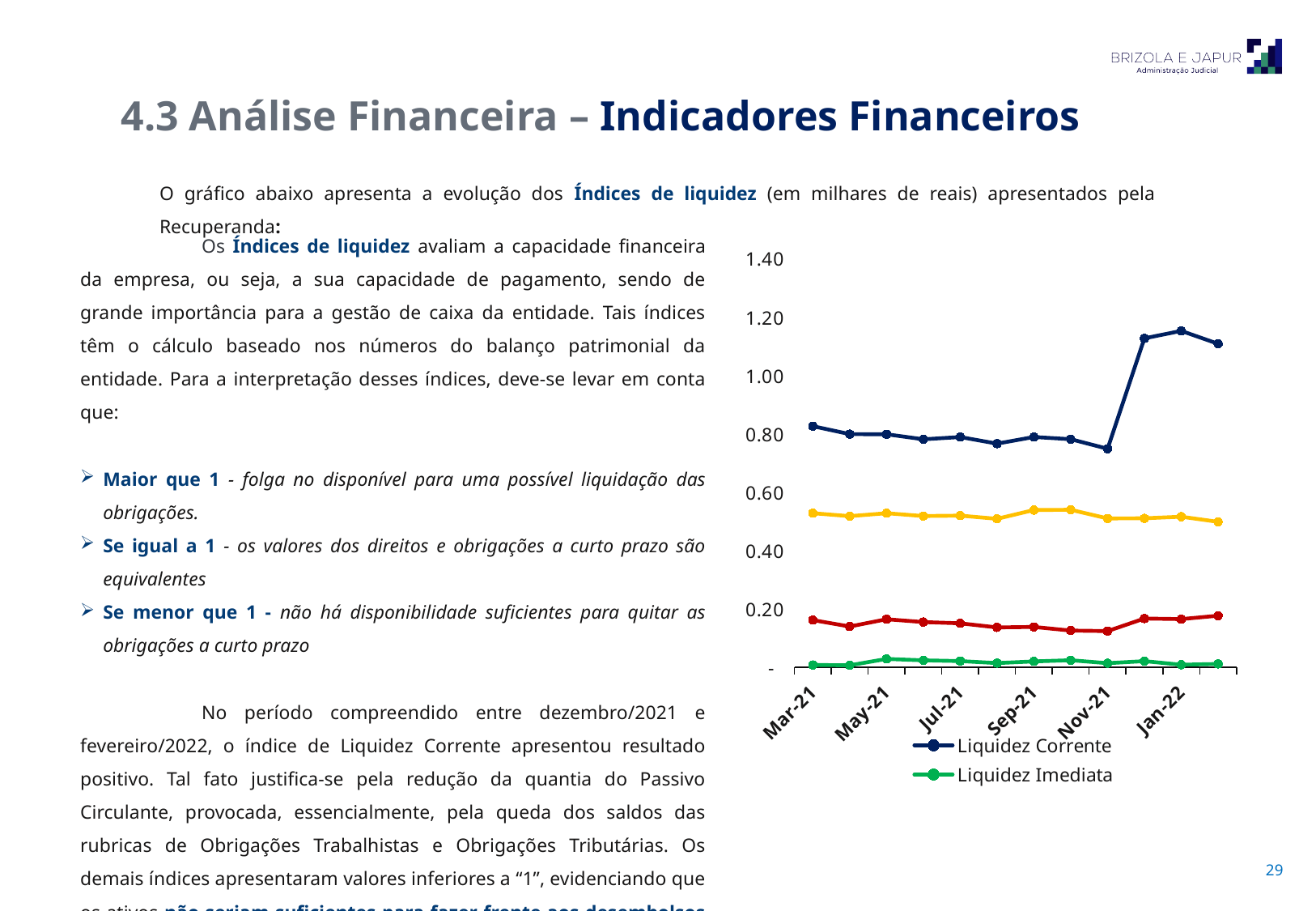
Is the value of Liquidez Imediata at Jan-22 greater or less than 0.20? less What colour is the Liquidez Imediata line in the legend? green Is the value of Liquidez Corrente at Nov-21 greater or less than 0.60? greater Does Liquidez Corrente rise or fall between Nov-21 and Jan-22? rise Which series is plotted with the highest values across the whole period? Liquidez Corrente Is the value of Liquidez Corrente at Jan-22 greater or less than 1.00? greater Which series is plotted with the lowest values across the whole period? Liquidez Imediata What kind of chart is shown on the slide? line chart How many month labels are shown on the x axis? 6 At Jan-22, which is larger: Liquidez Corrente or Liquidez Imediata? Liquidez Corrente How many series does the chart legend list? 2